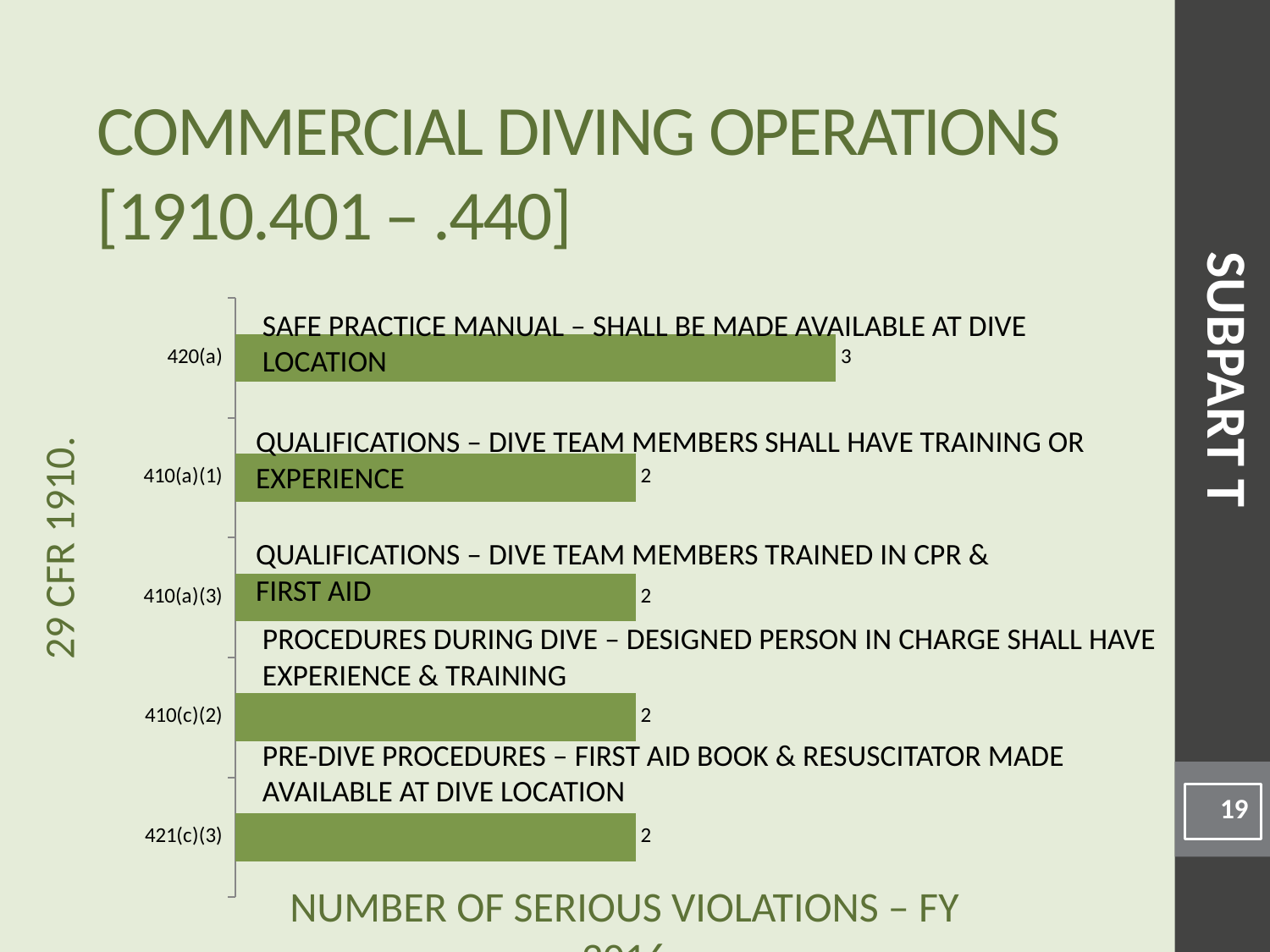
What is the number of serious violations for 420(a)? 3 How many categories have a value of 2? 4 What is the number of serious violations for 410(a)(1)? 2 What colour are the bars in the chart? Green What is the number of serious violations for 421(c)(3)? 2 What is the difference between the values for 420(a) and 410(c)(2)? 1 What kind of chart is shown on the slide? Bar chart Which is larger, the value for 420(a) or the value for 410(a)(3)? 420(a) Which category has the highest number of serious violations? 420(a) How many categories are shown in the chart? 5 What is the total number of serious violations across all five categories? 11